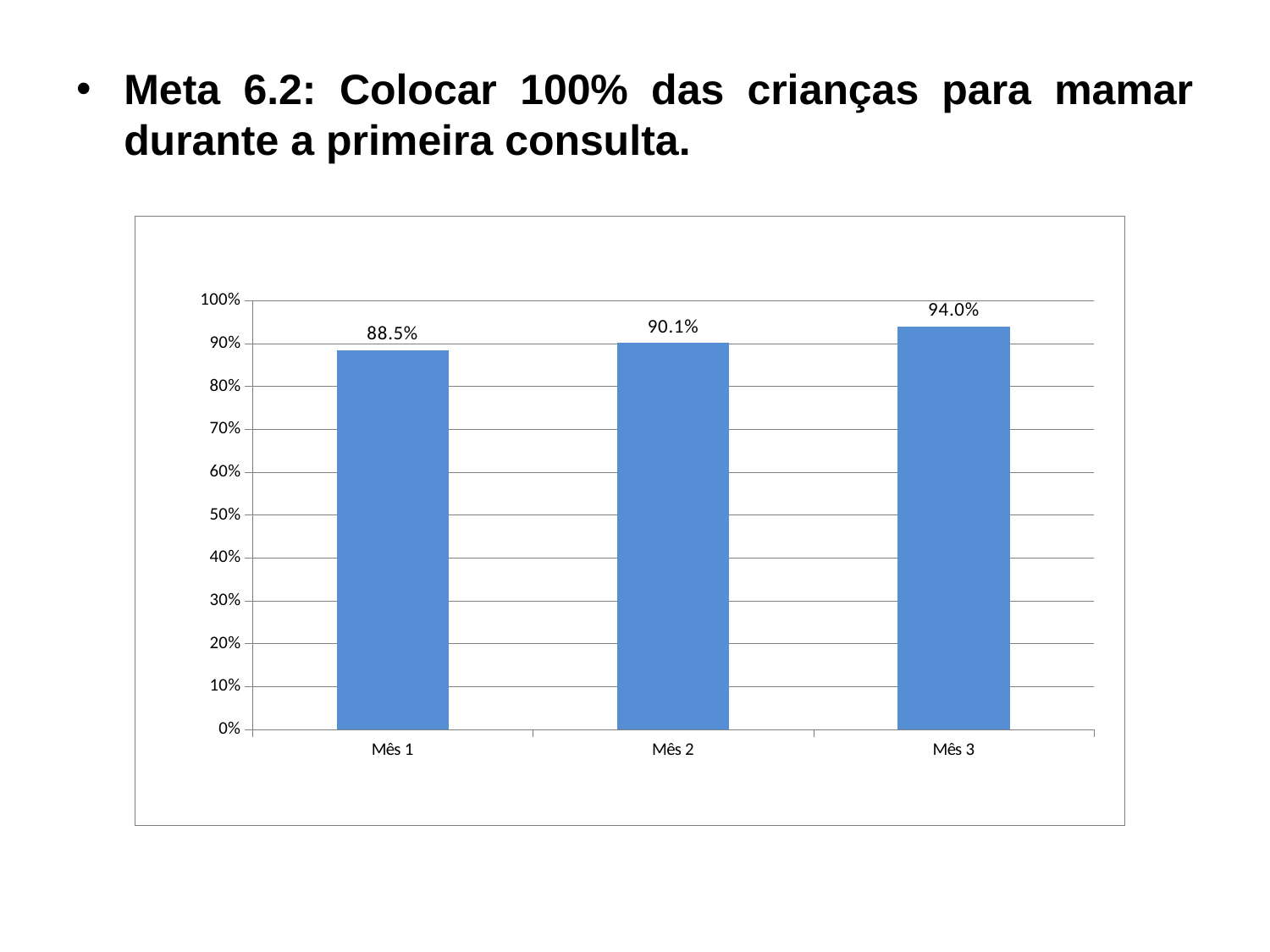
What is the value for Mês 2? 90.1% What kind of chart is shown on the slide? bar chart How many categories are shown on the x axis? 3 Which category has the highest value? Mês 3 Which category has the lowest value? Mês 1 Is the value for Mês 1 greater or less than 90%? less What is the value for Mês 1? 88.5% What is the difference between the values for Mês 2 and Mês 1? 1.6% What is the difference between the values for Mês 3 and Mês 1? 5.5% What is the value for Mês 3? 94.0% Do the values rise or fall from Mês 1 to Mês 3? rise Which is larger, the value for Mês 2 or the value for Mês 3? Mês 3